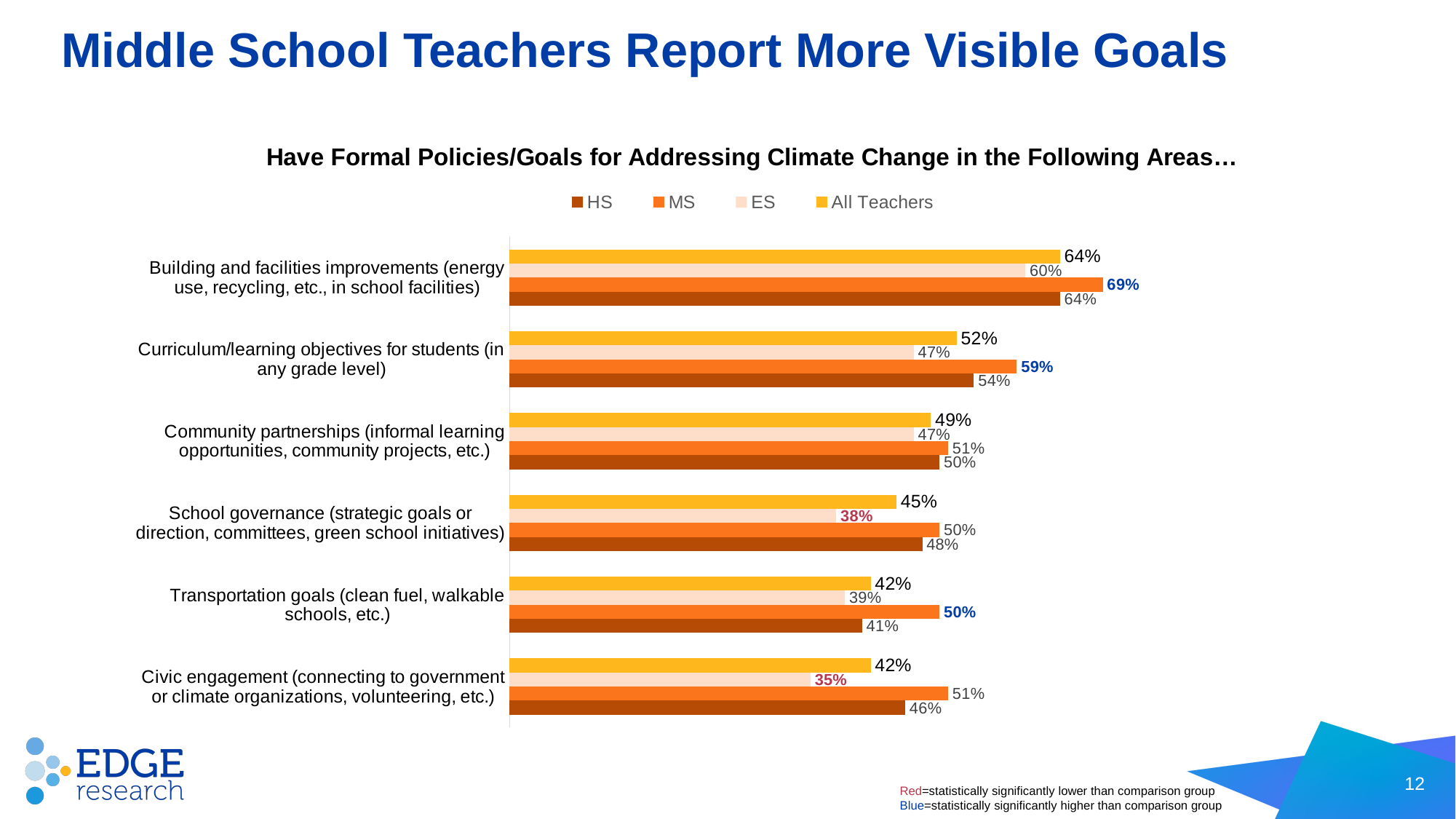
What is the HS value for curriculum/learning objectives for students? 54% How many series does the legend list? 4 Which area has the lowest ES value? Civic engagement What is the All Teachers value for transportation goals? 42% What percentage of MS teachers report formal policies/goals for building and facilities improvements? 69% What is the difference between the MS and ES values for school governance? 12% Which area has the highest All Teachers value? Building and facilities improvements What kind of chart is shown on the slide? Bar chart What is the title of the chart? Have Formal Policies/Goals for Addressing Climate Change in the Following Areas… For transportation goals, which is larger: the MS value or the HS value? MS How many areas (categories) are shown on the chart? 6 What is the ES value for civic engagement? 35%